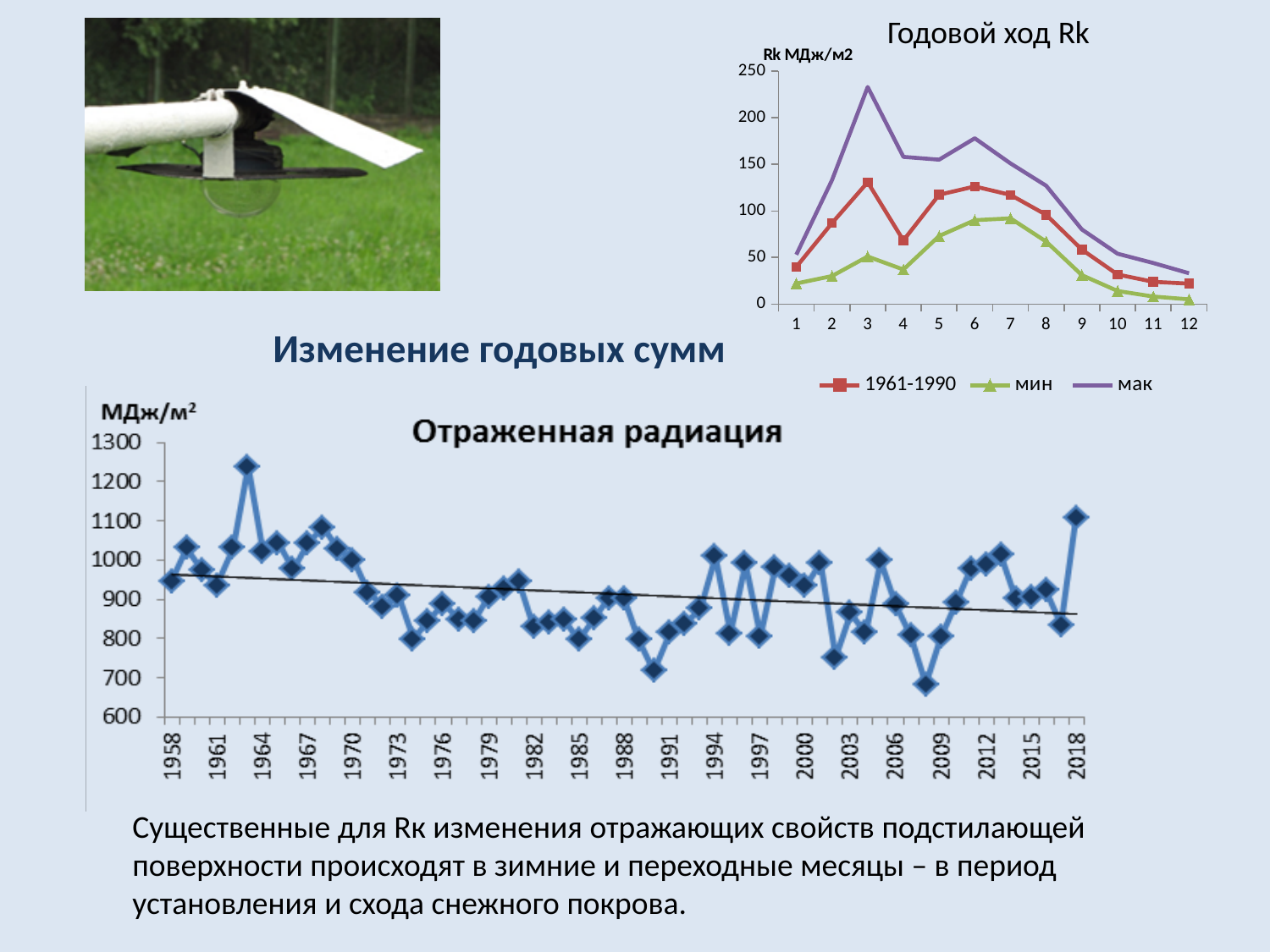
On the 'Годовой ход Rk' chart, is the 'мак' value for month 3 greater or less than 200? greater On the 'Годовой ход Rk' chart, which series is higher in month 6: '1961-1990' or 'мин'? 1961-1990 On the 'Отраженная радиация' chart, which year has the lowest value? 2008 On the 'Годовой ход Rk' chart, in which month does the 'мин' series reach its lowest value? 12 What kind of chart is the 'Годовой ход Rk' chart? line chart On the 'Годовой ход Rk' chart, in which month does the 'мак' series reach its highest value? 3 On the 'Отраженная радиация' chart, does the trend line rise or fall from 1958 to 2018? fall How many series does the legend of the 'Годовой ход Rk' chart list? 3 On the 'Годовой ход Rk' chart, is the 'мин' value for month 3 greater or less than 100? less What kind of chart is the 'Отраженная радиация' chart? line chart On the 'Отраженная радиация' chart, which year has the highest value? 1963 How many months (x-axis points) are plotted on the 'Годовой ход Rk' chart? 12